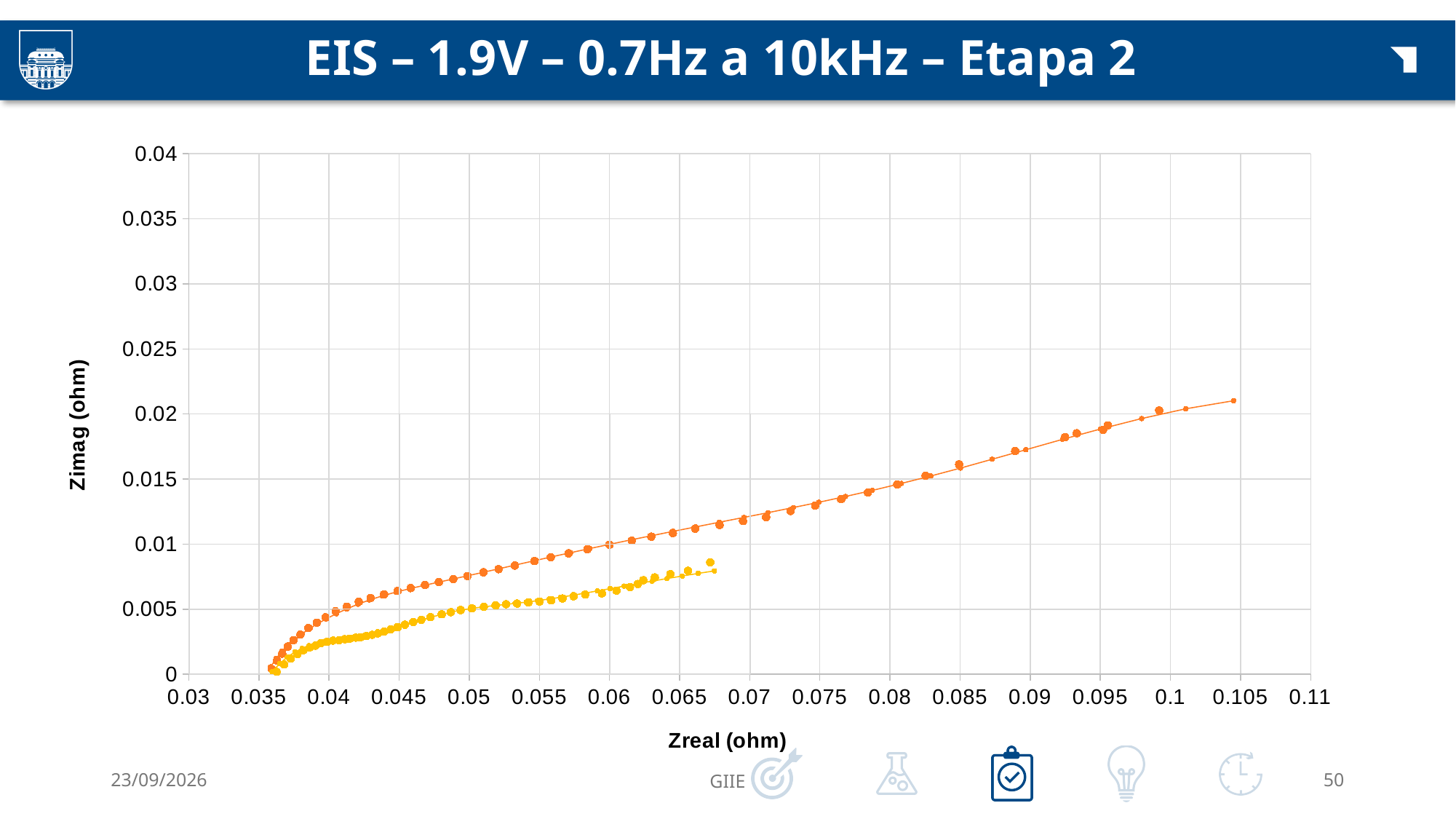
Is the highest Zimag value of the orange series greater or less than 0.015? greater Which series reaches the higher maximum Zimag value, the orange or the yellow one? Orange Do the Zimag values of the orange series rise or fall as Zreal increases? Rise Which series extends to the larger Zreal value, the orange or the yellow one? Orange Is the largest Zreal value of the yellow series greater or less than 0.07? less What kind of chart is shown on the slide? Scatter chart Do the Zimag values of the yellow series rise or fall as Zreal increases? Rise What is the title of the vertical axis of the chart? Zimag (ohm) Is the largest Zreal value of the orange series greater or less than 0.1? greater What is the title of the horizontal axis of the chart? Zreal (ohm)